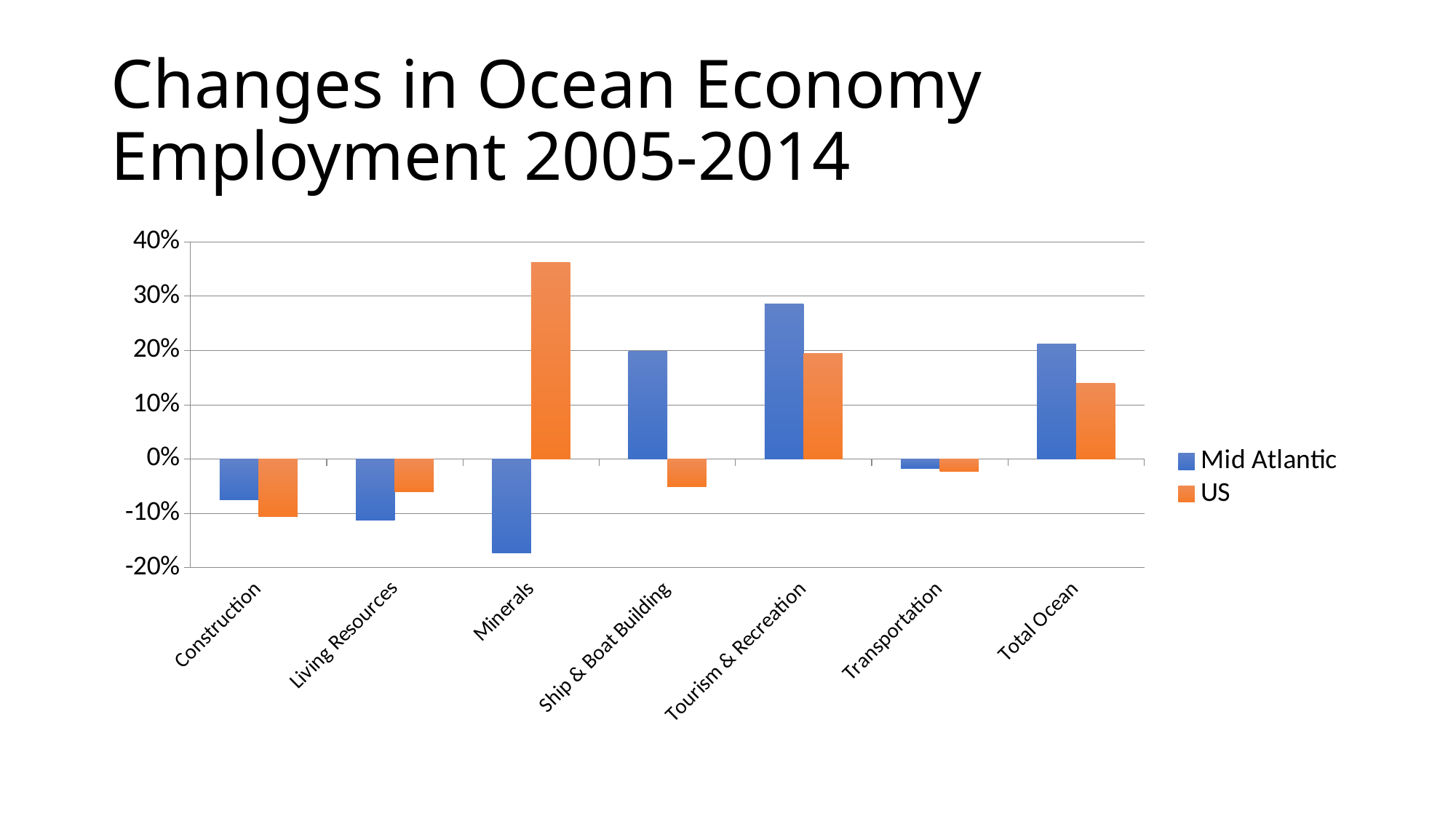
Which category has the lowest Mid Atlantic value? Minerals Is the Mid Atlantic value for Minerals greater or less than -10%? less Is the US value for Total Ocean greater or less than 10%? greater For Tourism & Recreation, which series has the larger value, Mid Atlantic or US? Mid Atlantic How many categories are shown on the x axis? 7 Which category has the highest Mid Atlantic value? Tourism & Recreation For Living Resources, which series has the lower value, Mid Atlantic or US? Mid Atlantic Which category has the lowest US value? Construction What kind of chart is shown on the slide? bar chart Is the US value for Minerals greater or less than 30%? greater How many series does the legend list? 2 Which category has the highest US value? Minerals